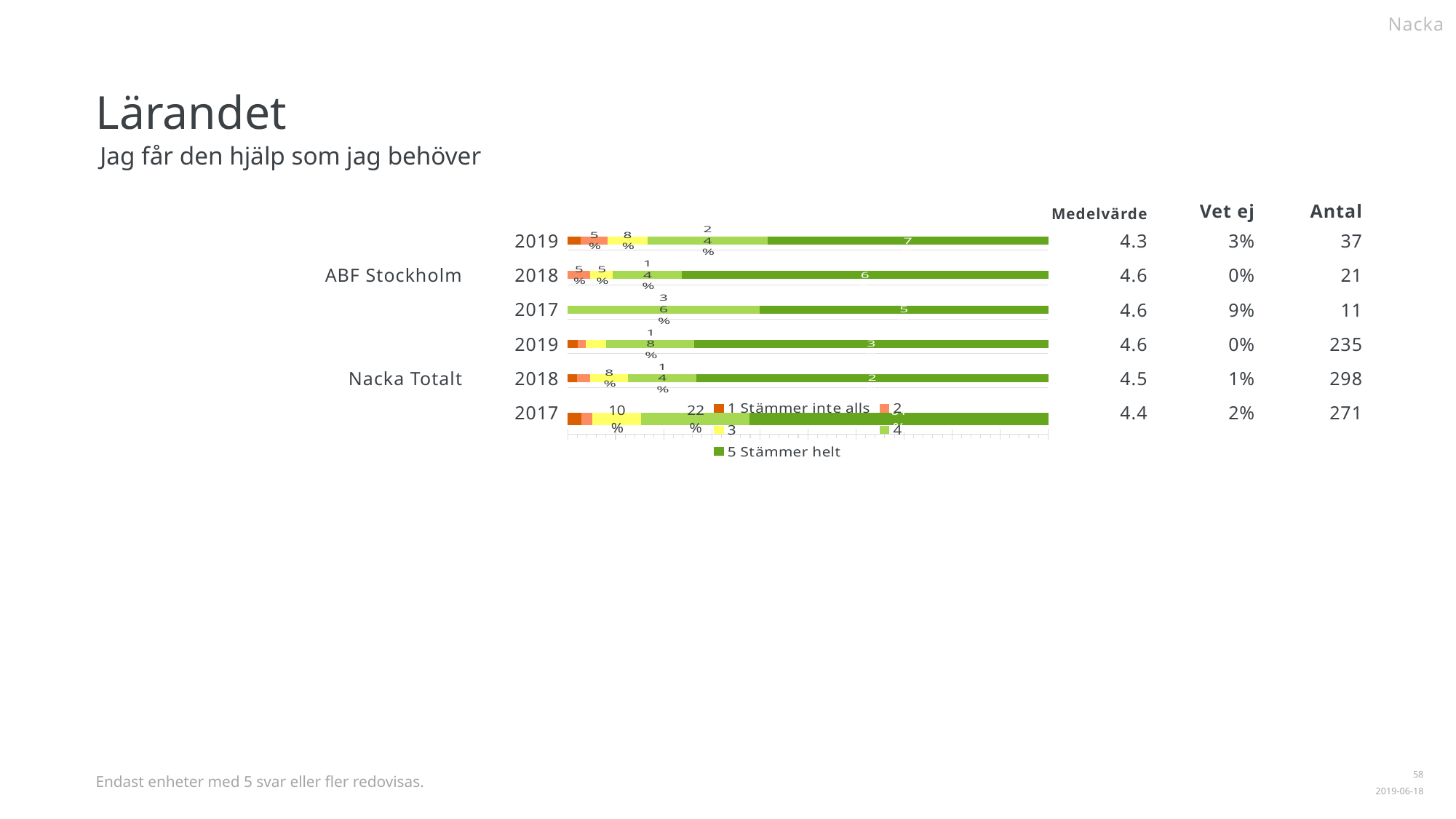
What is the difference between the '4' segment for ABF Stockholm 2017 (36%) and the '4' segment for Nacka Totalt 2019 (18%)? 18 percentage points What is the value of the '4' segment for ABF Stockholm in 2017? 36% How many series does the chart legend list? 5 What kind of chart is shown on the slide? Stacked bar chart What is the value of the '3' segment for Nacka Totalt in 2017? 10% What is the value of the '4' segment for Nacka Totalt in 2017? 22% Which bar has the largest '4' segment? ABF Stockholm 2017 What is the value of the '4' segment for Nacka Totalt in 2018? 14% What is the label of the dark green series in the legend? 5 Stämmer helt Which is larger: the '4' segment for ABF Stockholm 2017 or the '4' segment for Nacka Totalt 2019? ABF Stockholm 2017 How many bars are plotted in the chart? 6 What is the value of the '4' segment for Nacka Totalt in 2019? 18%